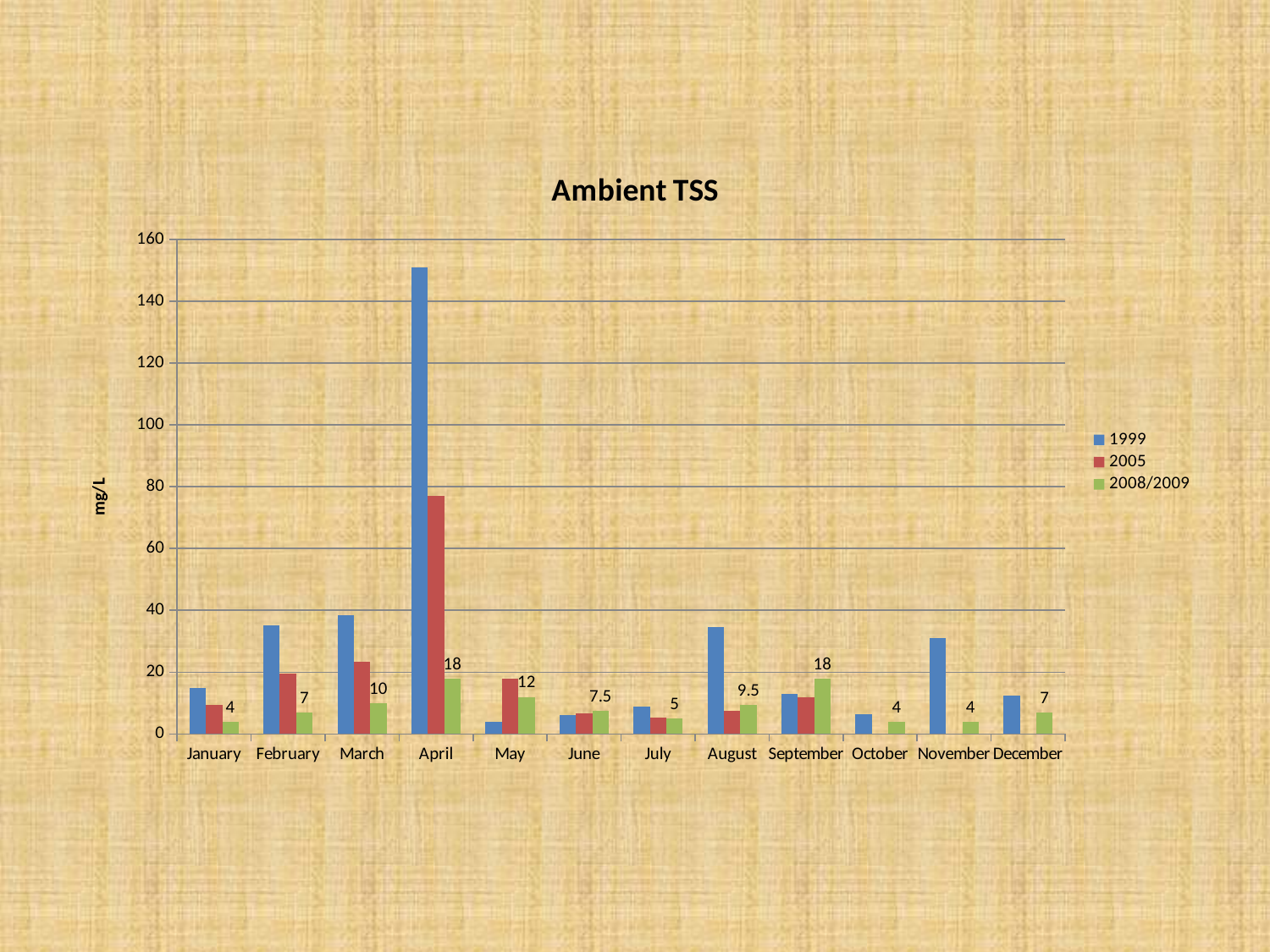
What is the 2008/2009 value for May? 12 What is the 2008/2009 value for April? 18 Is the 1999 value for April greater or less than 140? greater What kind of chart is shown? bar chart Which month has the highest value for the 1999 series? April How many months are shown on the x axis? 12 How many series does the legend list? 3 What is the 2008/2009 value for June? 7.5 What is the difference between the 2008/2009 values for April and March? 8 Is the 2005 value for April greater or less than 60? greater What is the difference between the 2008/2009 values for September and August? 8.5 For the 2008/2009 series, which is larger: May or August? May